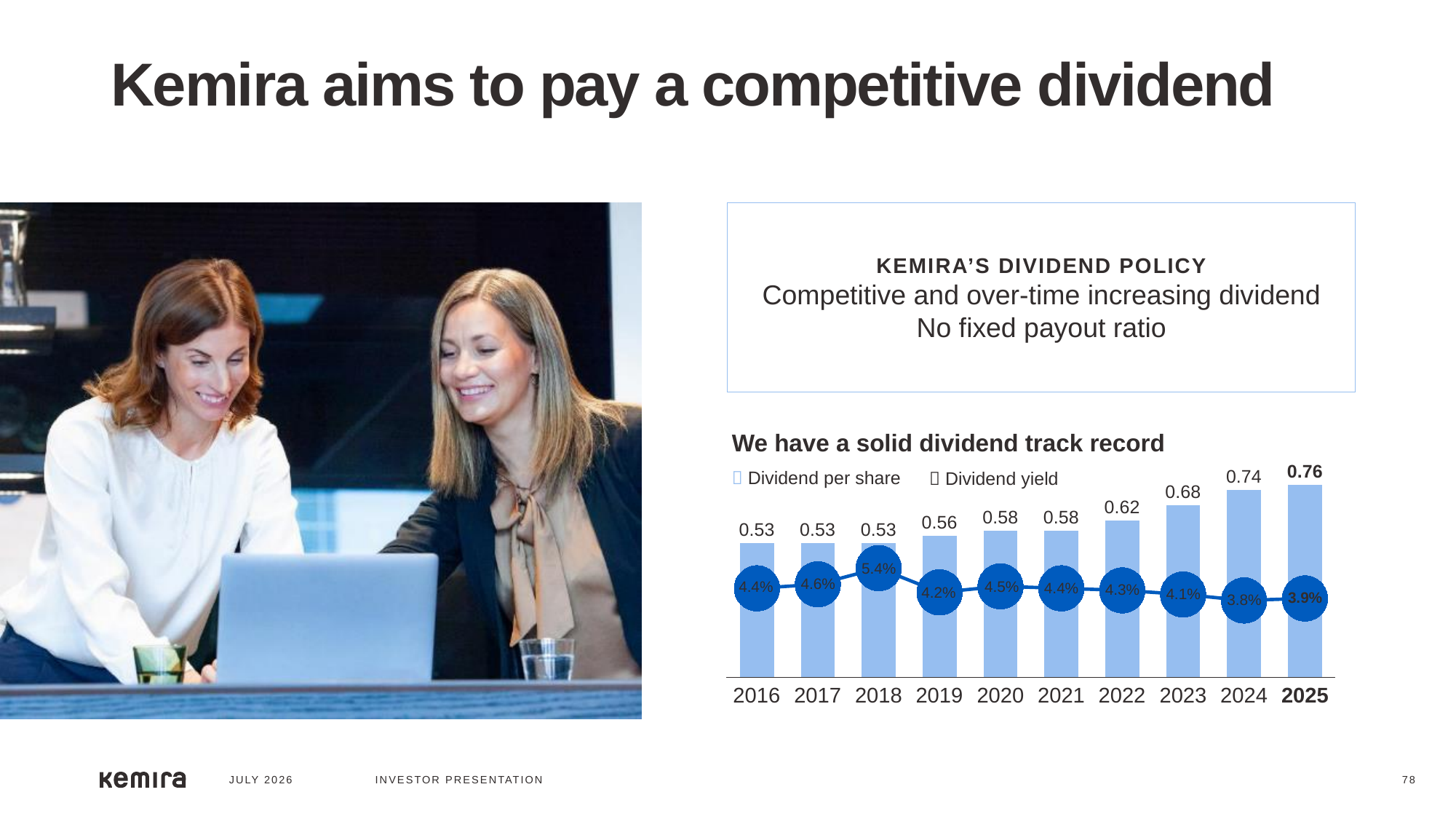
What is the dividend per share for 2025? 0.76 What is the dividend yield for 2018? 5.4% What is the difference in dividend per share between 2025 and 2016? 0.23 Does the dividend per share rise or fall from 2016 to 2025? rise Is the dividend per share larger in 2022 or in 2021? 2022 Which year has the lowest dividend yield? 2024 How many years are shown on the x axis of the chart? 10 Which year has the highest dividend per share? 2025 What is the dividend yield for 2024? 3.8% What is the dividend per share for 2019? 0.56 How many series does the chart legend list? 2 Which year has the highest dividend yield? 2018